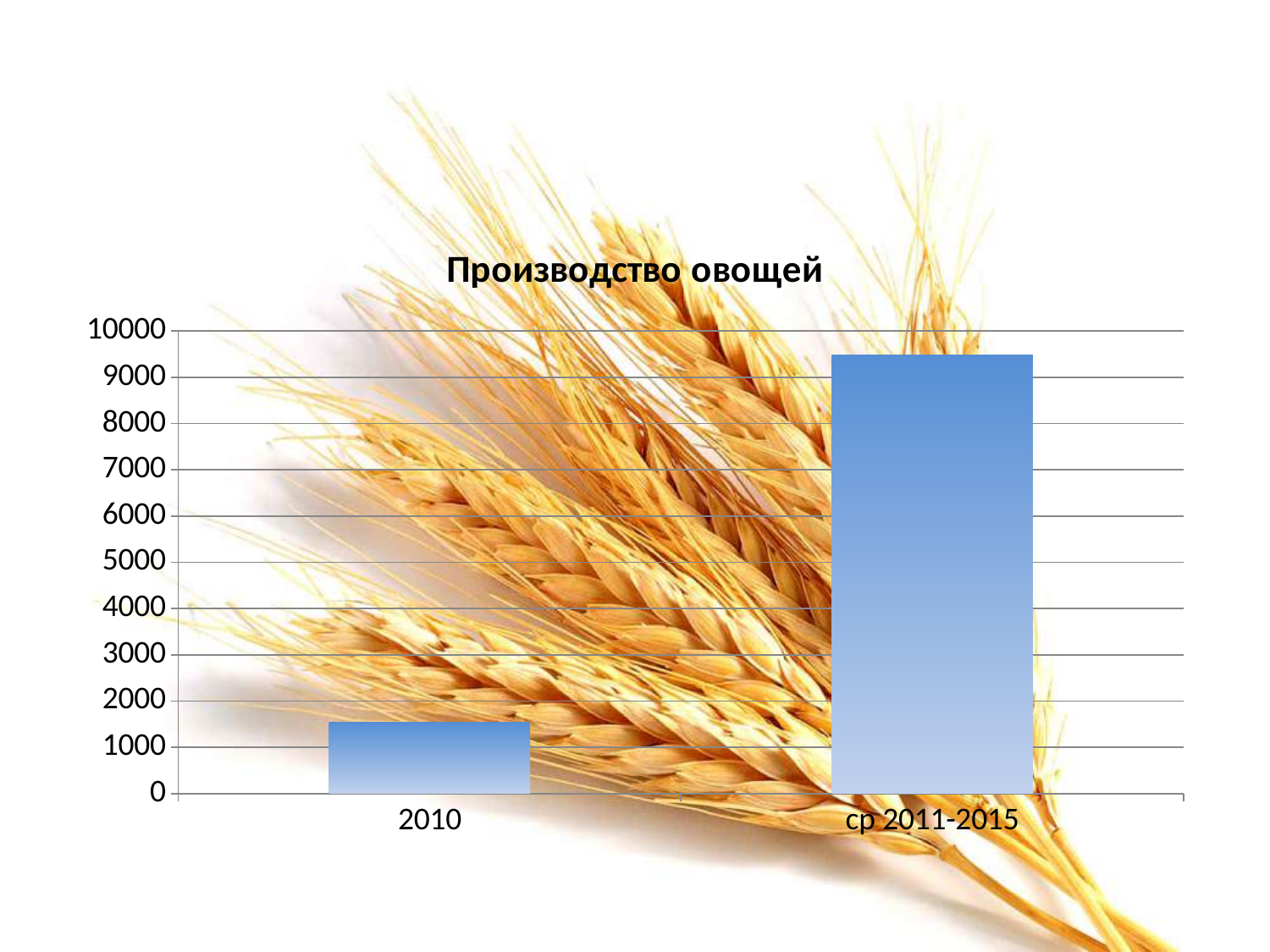
What is the title of the chart? Производство овощей Is the value for ср 2011-2015 greater or less than 10000? less Which category has the highest value in the chart? ср 2011-2015 What kind of chart is shown on the slide? bar chart What is the highest value shown on the vertical axis of the chart? 10000 Is the value for ср 2011-2015 greater or less than 9000? greater Is the value for 2010 greater or less than 2000? less How many categories are shown on the x axis of the chart? 2 Which is larger, the value for 2010 or the value for ср 2011-2015? ср 2011-2015 Which category has the lowest value in the chart? 2010 Do the values rise or fall from 2010 to ср 2011-2015? rise